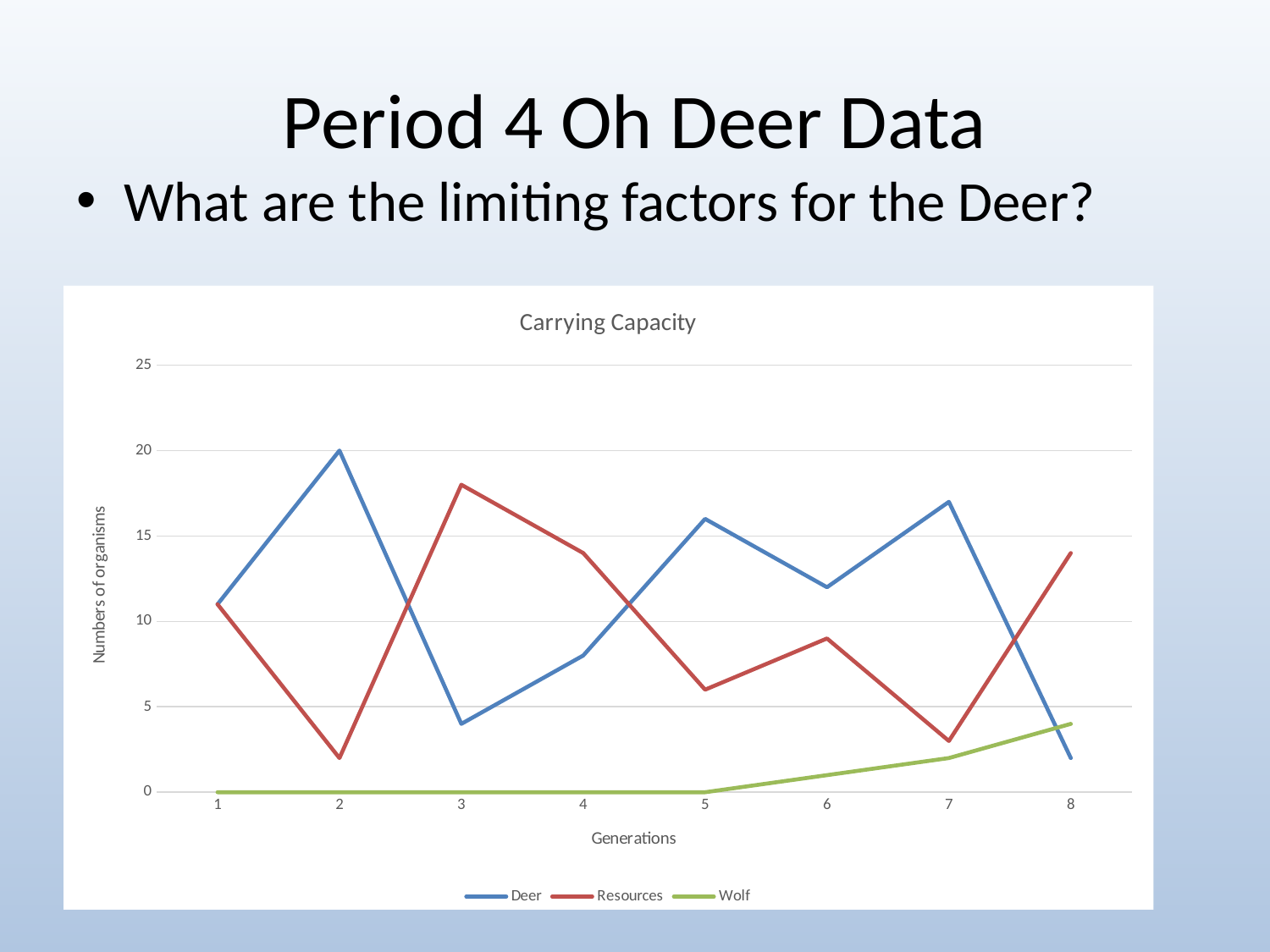
At which generation is the Deer value lowest? 8 Is the value for Resources at generation 3 greater or less than 15? greater Is the value for Deer at generation 3 greater or less than 5? less At generation 7, which is larger, Deer or Resources? Deer At which generation is the Deer value highest? 2 What is the value for Wolf at generation 1? 0 What is the title of the chart? Carrying Capacity How many series does the legend list? 3 What is the value for Deer at generation 2? 20 Does the Wolf series rise or fall from generation 5 to generation 8? rise What kind of chart is shown on the slide? line chart How many generations are plotted along the x axis? 8